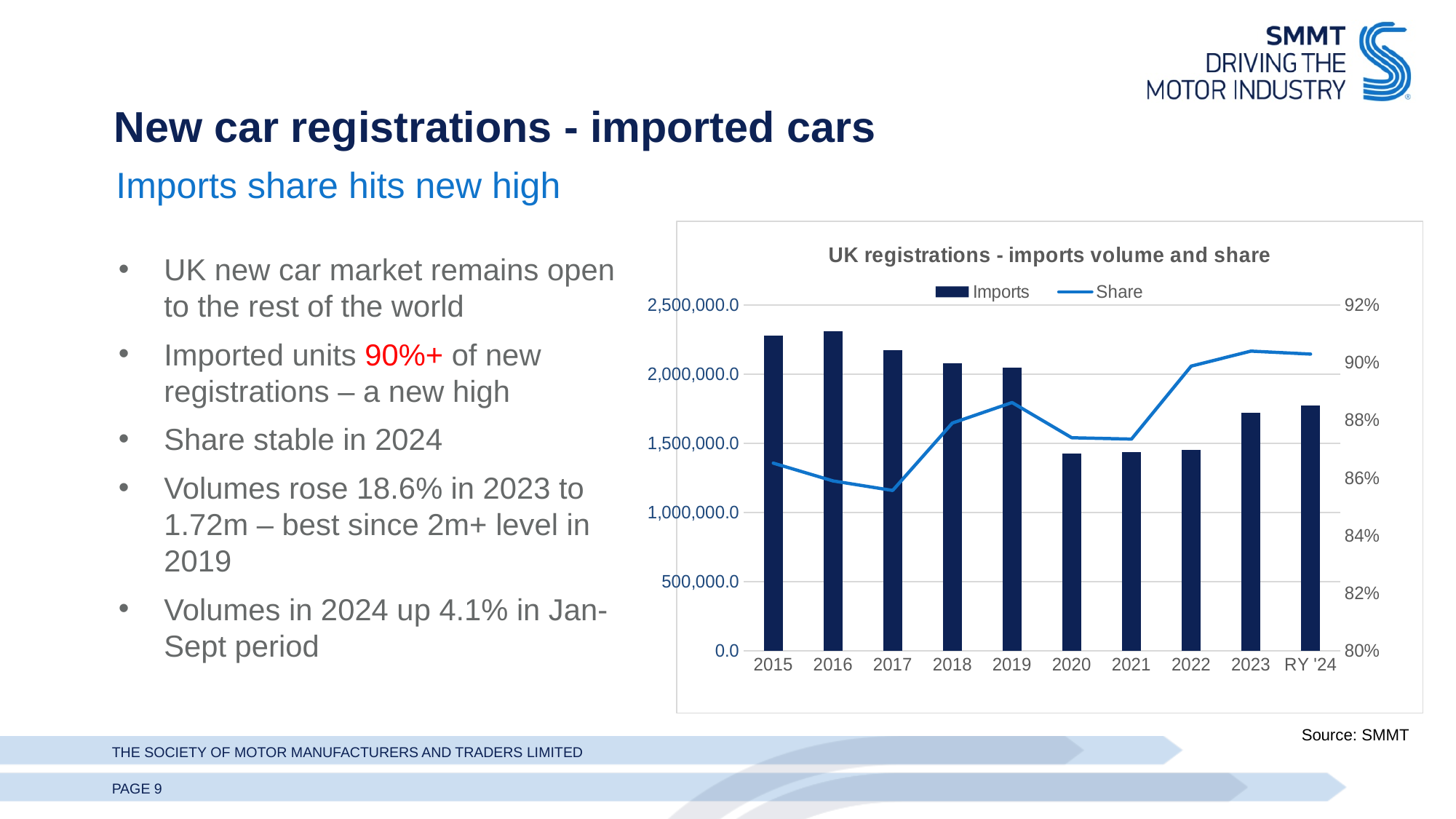
Is the Imports value for 2015 greater or less than 2,000,000.0? greater What is the title of the chart? UK registrations - imports volume and share How many time periods are shown on the x axis of the chart? 10 Is the Imports value for 2023 greater or less than 1,500,000.0? greater Which series is plotted as bars in the chart? Imports Is the Share value for 2015 greater or less than 88%? less Which year has the higher Share value, 2017 or 2023? 2023 How many series does the chart legend list? 2 Which year has the larger Imports value, 2015 or 2023? 2015 What kind of chart is shown on the slide? A combination bar and line chart